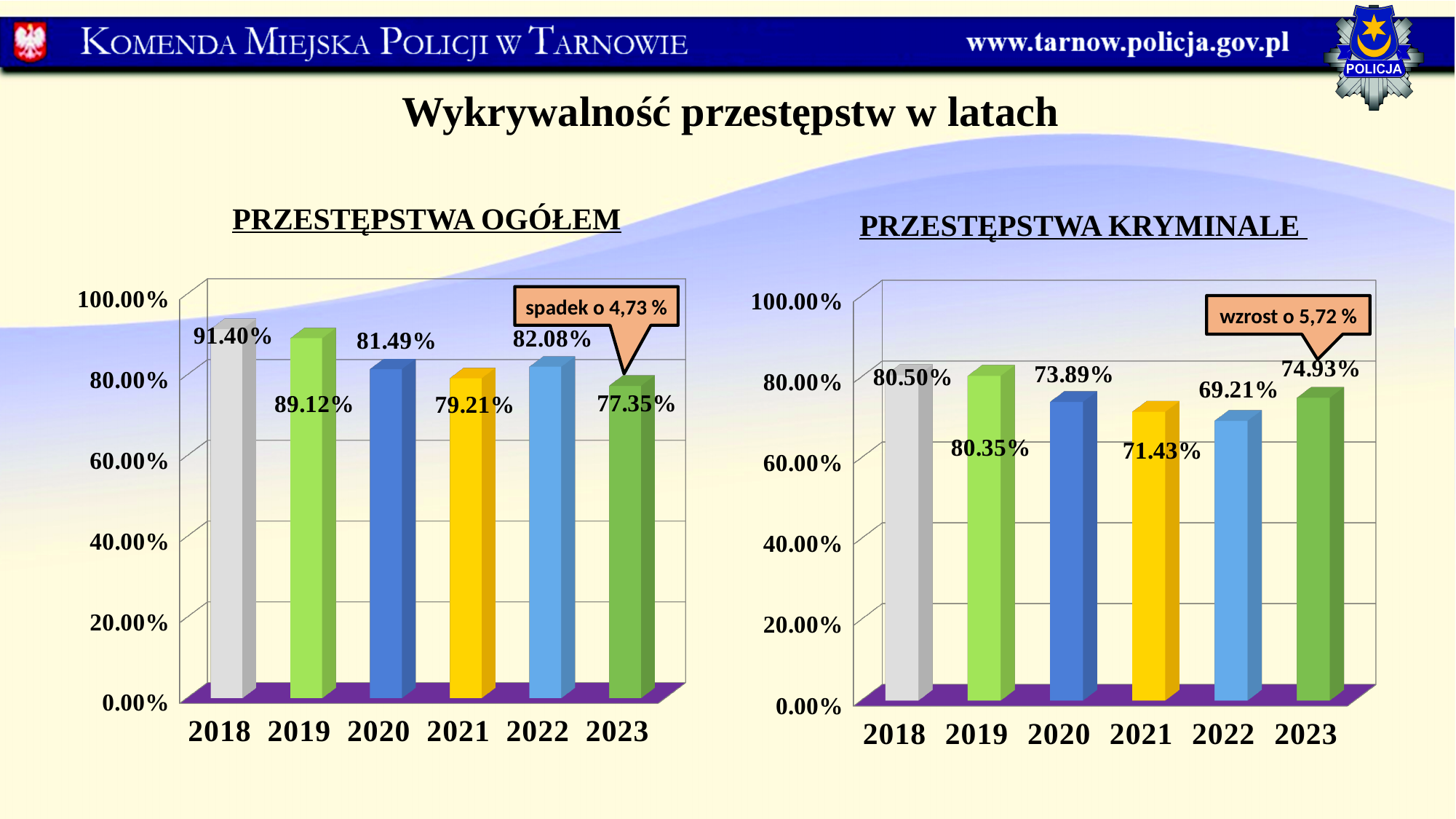
In the PRZESTĘPSTWA KRYMINALNE chart, which year has the lowest value? 2022 In the PRZESTĘPSTWA KRYMINALNE chart, what is the difference between the values for 2023 and 2022? 5.72% In the PRZESTĘPSTWA OGÓŁEM chart, what is the value for 2018? 91.40% In the PRZESTĘPSTWA OGÓŁEM chart, is the value for 2021 greater or less than 80.00%? less In the PRZESTĘPSTWA KRYMINALNE chart, does the value rise or fall from 2022 to 2023? rise In the PRZESTĘPSTWA OGÓŁEM chart, what is the difference between the values for 2022 and 2023? 4.73% What kind of chart is the PRZESTĘPSTWA OGÓŁEM chart? bar chart In the PRZESTĘPSTWA OGÓŁEM chart, which year has the highest value? 2018 In the PRZESTĘPSTWA KRYMINALNE chart, what is the value for 2022? 69.21% What does the callout on the PRZESTĘPSTWA OGÓŁEM chart say? spadek o 4,73 % How many years are shown on the x axis of the PRZESTĘPSTWA KRYMINALNE chart? 6 In the PRZESTĘPSTWA KRYMINALNE chart, which is larger, the value for 2020 or the value for 2021? 2020